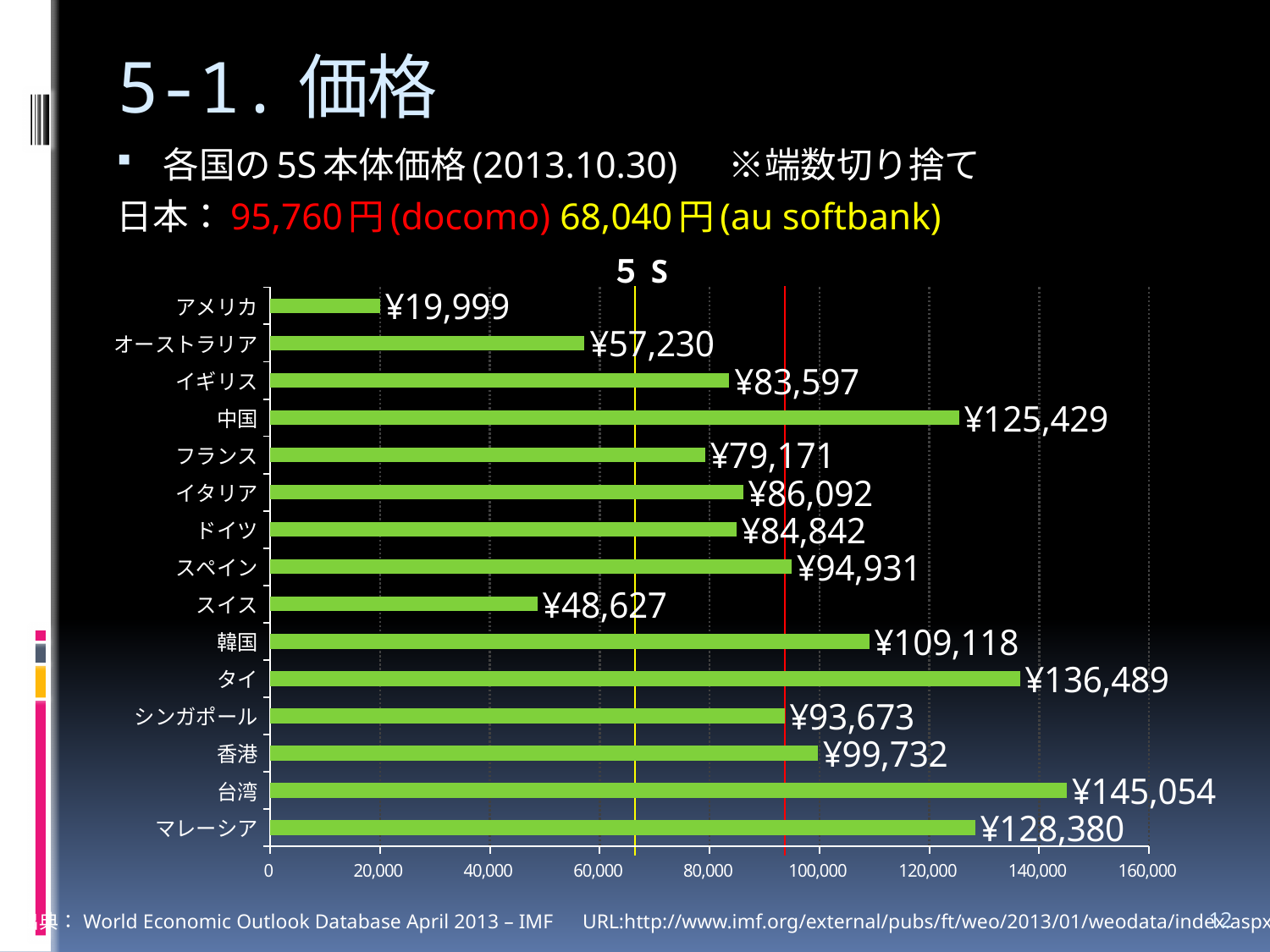
Which has a larger value, 香港 or ドイツ? 香港 What is the value for スイス in the chart? ¥48,627 What is the title of the chart? 5 S Which country has the lowest value in the chart? アメリカ How many countries are shown in the chart? 15 Which country has the highest value in the chart? 台湾 What is the difference between the values for 中国 and 韓国? ¥16,311 What kind of chart is shown on the slide? bar chart Is the value for 韓国 greater or less than 100,000? greater What is the value for 台湾 in the chart? ¥145,054 What is the difference between the values for 台湾 and アメリカ? ¥125,055 What is the value for 韓国 in the chart? ¥109,118